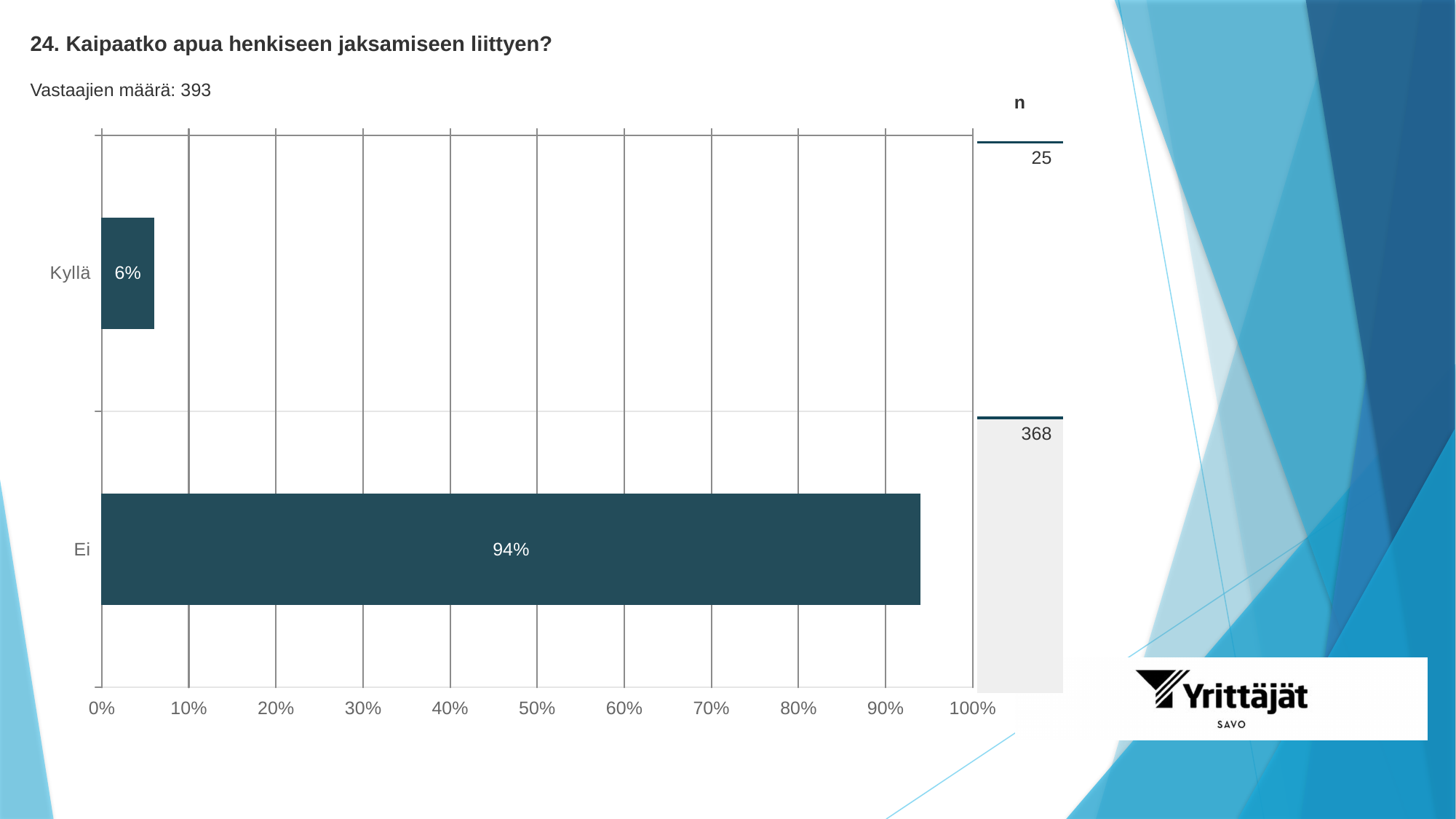
What is the number of respondents (Vastaajien määrä) stated on the slide? 393 What is the n value shown for Kyllä? 25 What percentage is shown for Ei? 94% What percentage is shown for Kyllä? 6% What is the difference in percentage points between Ei and Kyllä? 88 What kind of chart is shown on the slide? bar chart How many categories are shown in the chart? 2 Which is larger, the value for Kyllä or the value for Ei? Ei Which category has the highest percentage? Ei What is the n value shown for Ei? 368 Is the value for Ei greater or less than 50%? greater Which category has the lowest percentage? Kyllä